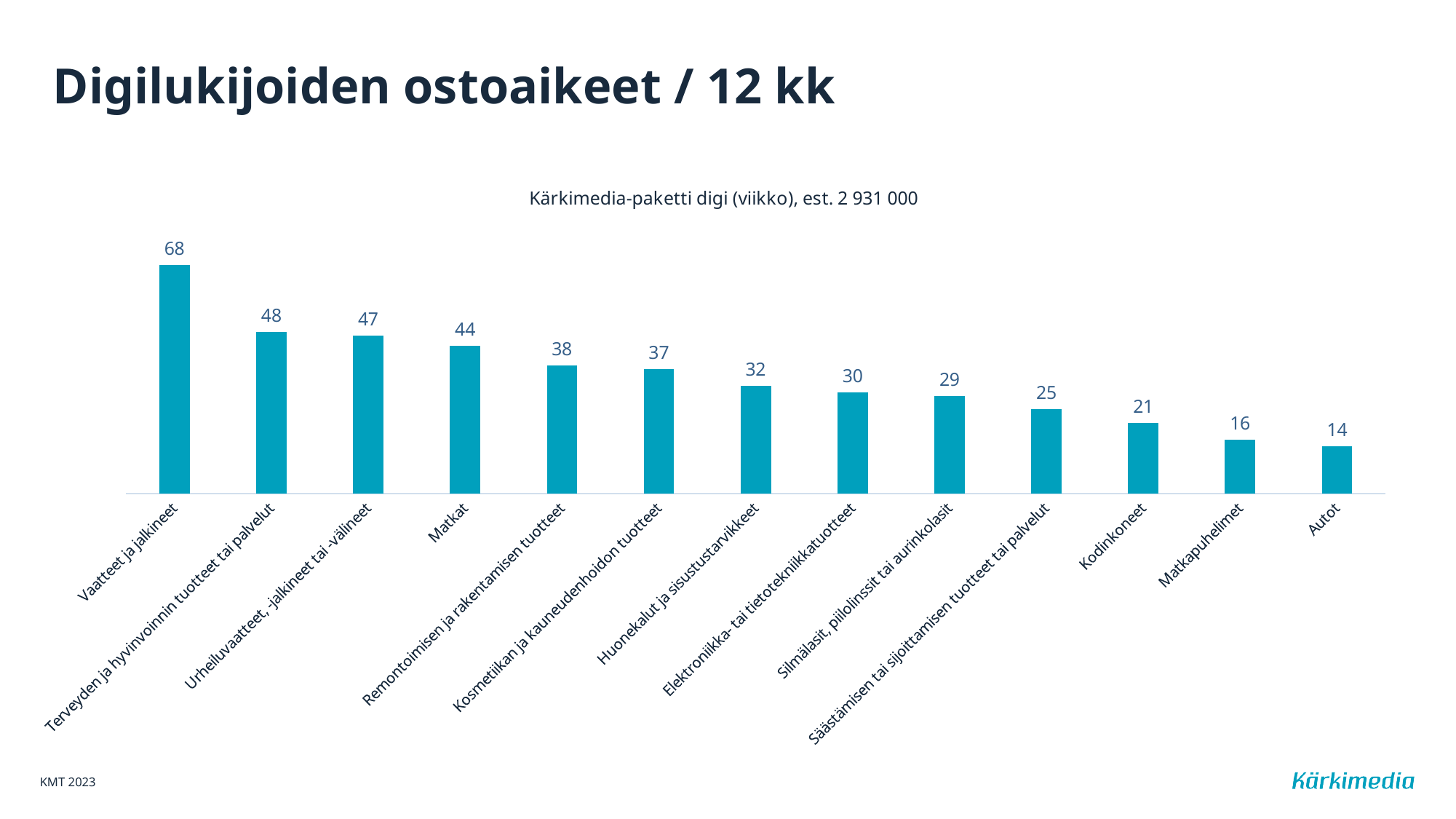
How many categories are shown in the chart? 13 What is the value for Kodinkoneet? 21 What is the value for Huonekalut ja sisustustarvikkeet? 32 What is the difference between the values for Vaatteet ja jalkineet and Autot? 54 Which category has the lowest value? Autot What kind of chart is shown on the slide? Bar chart Which category has the highest value? Vaatteet ja jalkineet Do the values rise or fall from left to right along the x axis? Fall What is the value for Matkat? 44 Which is larger, the value for Kosmetiikan ja kauneudenhoidon tuotteet or the value for Kodinkoneet? Kosmetiikan ja kauneudenhoidon tuotteet What is the subtitle shown above the chart? Kärkimedia-paketti digi (viikko), est. 2 931 000 What is the difference between the values for Matkat and Matkapuhelimet? 28